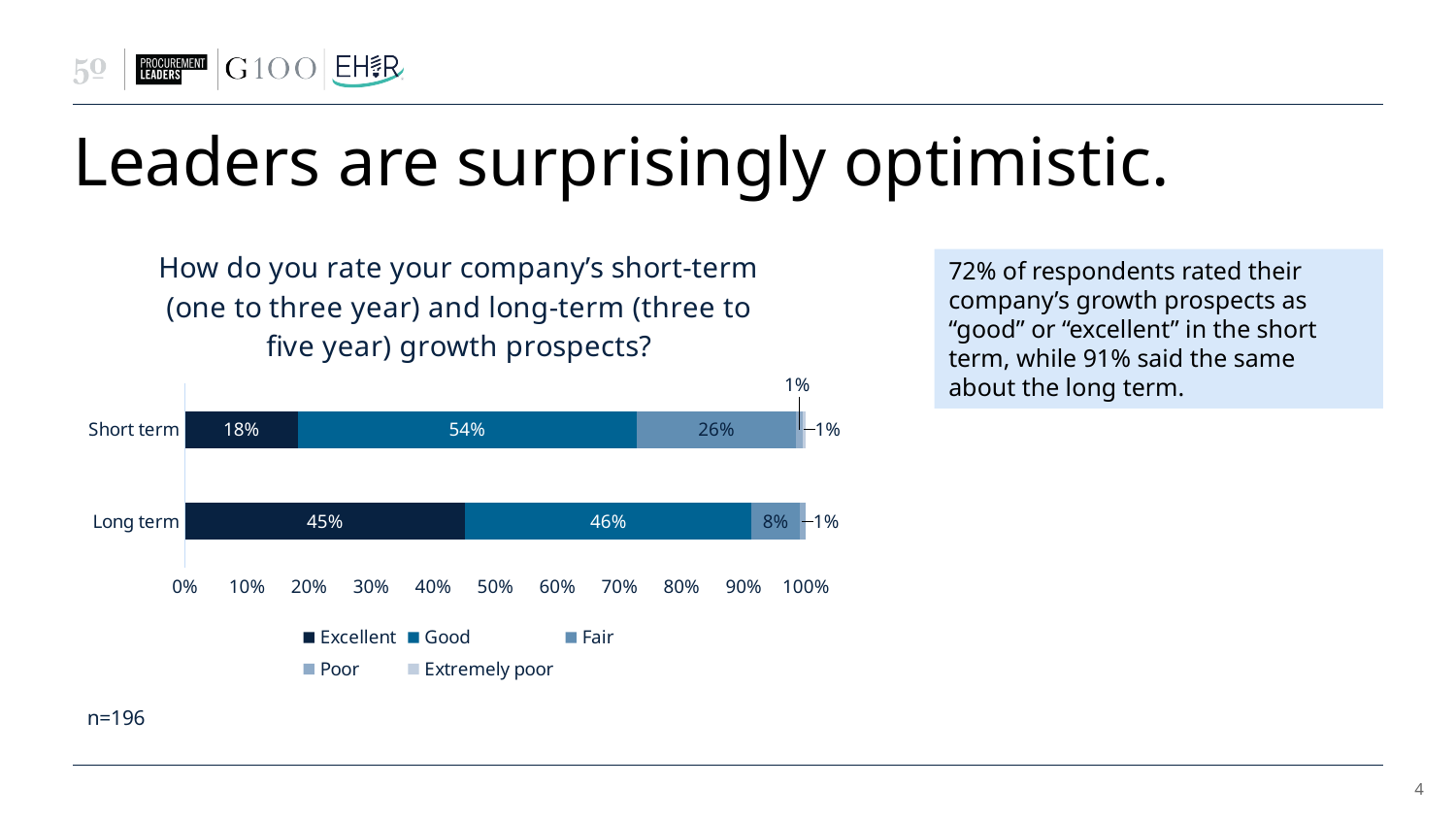
Which category has the larger Excellent share, Short term or Long term? Long term What is the Fair share for the Short term bar? 26% What is the combined share of Excellent and Good ratings for the Long term bar? 91% What percentage of respondents rated their company's long-term growth prospects as Good? 46% What percentage of respondents rated their company's short-term growth prospects as Excellent? 18% How many series does the chart legend list? 5 What is the Fair share for the Long term bar? 8% What type of chart is shown on the slide? Stacked bar chart What is the sample size noted below the chart? n=196 What is the combined share of Excellent and Good ratings for the Short term bar? 72% How many categories (bars) are shown in the chart? 2 What is the difference between the Excellent share for Long term and the Excellent share for Short term? 27 percentage points